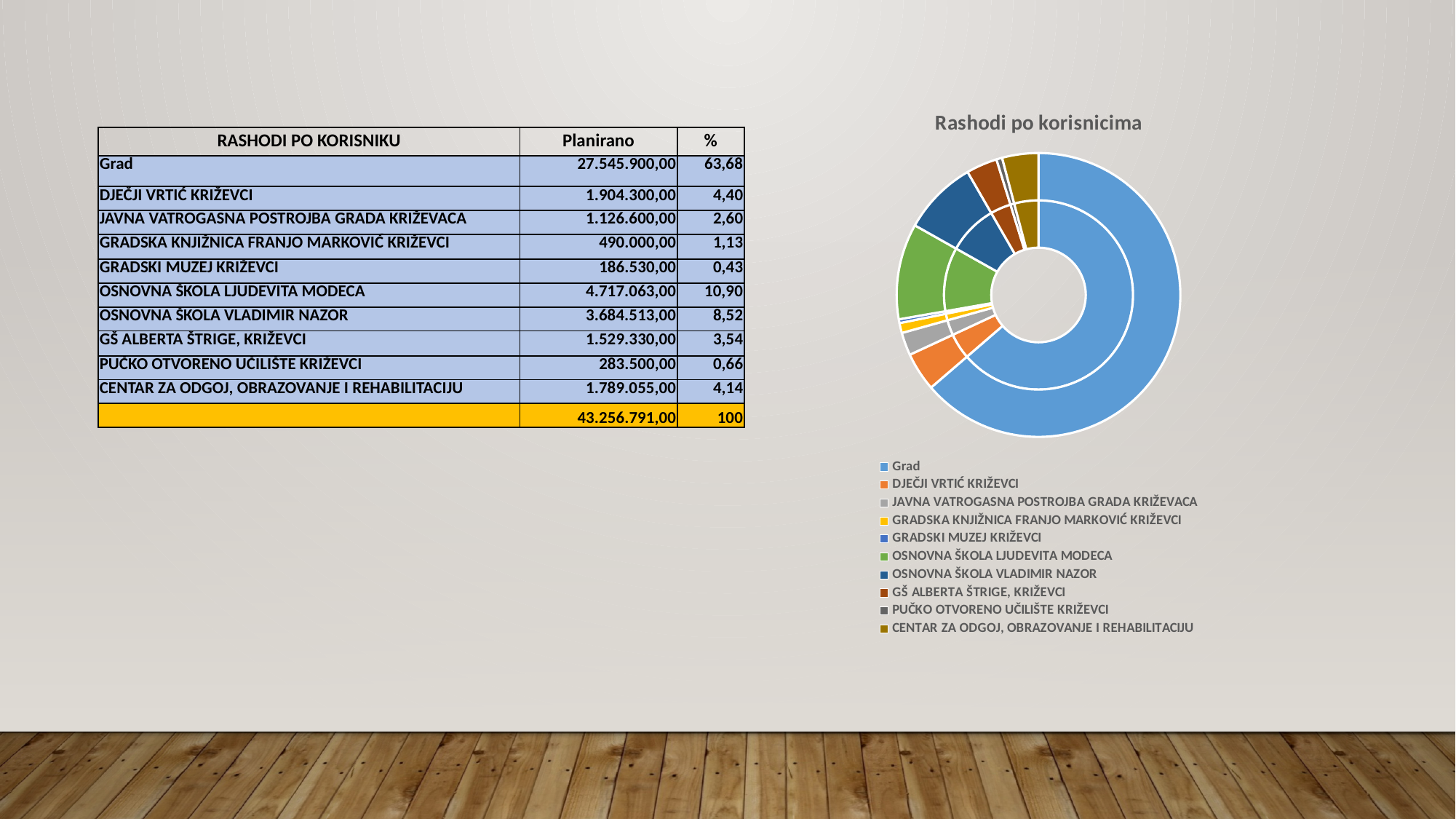
Which is larger, the slice for OSNOVNA ŠKOLA LJUDEVITA MODECA or the slice for OSNOVNA ŠKOLA VLADIMIR NAZOR? OSNOVNA ŠKOLA LJUDEVITA MODECA What colour represents Grad in the chart? blue How many entries does the chart legend list? 10 What is the planned amount (Planirano) for OSNOVNA ŠKOLA LJUDEVITA MODECA? 4.717.063,00 Which category has the smallest percentage share? GRADSKI MUZEJ KRIŽEVCI What is the title of the chart? Rashodi po korisnicima What share of the total does Grad account for? 63,68 What is the difference in percentage between OSNOVNA ŠKOLA LJUDEVITA MODECA and OSNOVNA ŠKOLA VLADIMIR NAZOR? 2,38 What kind of chart is shown on the slide? doughnut chart What percentage is shown for DJEČJI VRTIĆ KRIŽEVCI? 4,40 Which category has the largest slice in the chart? Grad What is the total planned amount across all categories? 43.256.791,00